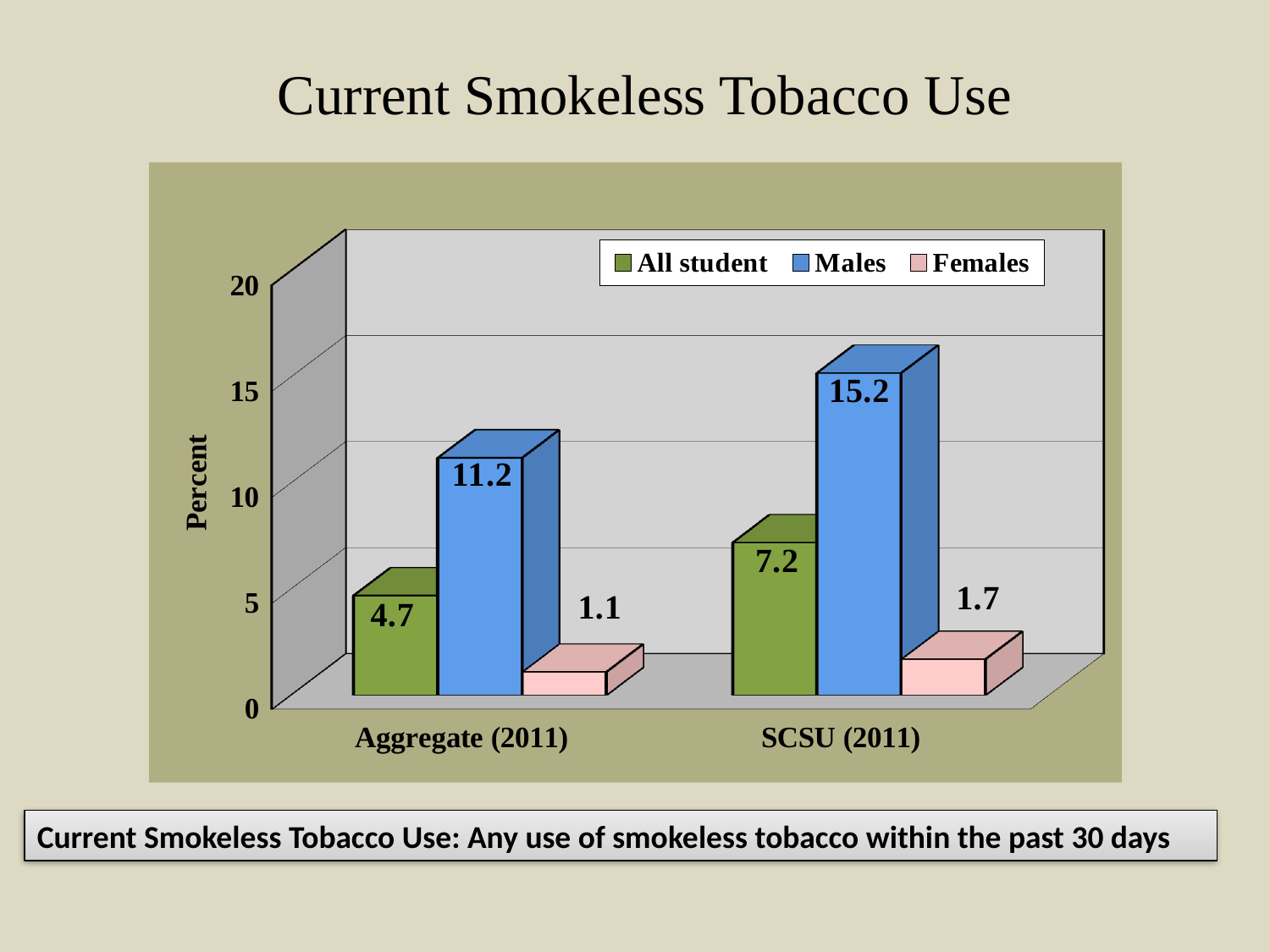
How many categories are shown on the x axis? 2 What is the difference between the Males values for SCSU (2011) and Aggregate (2011)? 4.0 What is the value for Males in the Aggregate (2011) category? 11.2 Which series has the lowest value in the Aggregate (2011) category? Females Which series has the highest value in the SCSU (2011) category? Males What is the difference between the All student values for SCSU (2011) and Aggregate (2011)? 2.5 What kind of chart is shown on the slide? Bar chart Which is larger, the Males value for Aggregate (2011) or the Males value for SCSU (2011)? SCSU (2011) How many series does the legend list? 3 What is the value for Females in the SCSU (2011) category? 1.7 What is the value for All student in the SCSU (2011) category? 7.2 What is the value for Females in the Aggregate (2011) category? 1.1